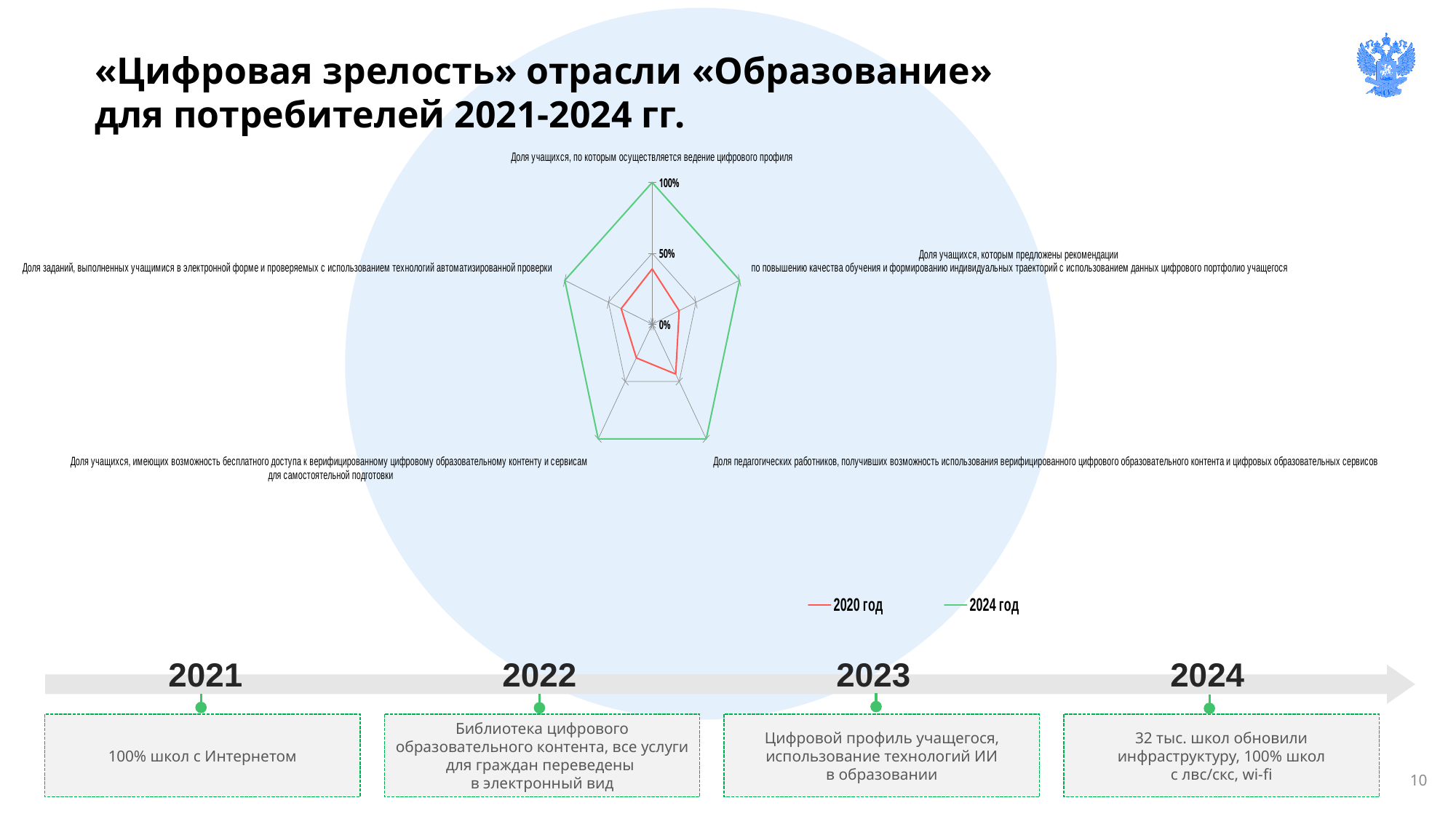
Is the 2024 год value for 'Доля учащихся, имеющих возможность бесплатного доступа к верифицированному цифровому образовательному контенту и сервисам для самостоятельной подготовки' greater or less than 50%? greater Which series has the larger value for 'Доля учащихся, которым предложены рекомендации по повышению качества обучения и формированию индивидуальных траекторий с использованием данных цифрового портфолио учащегося', 2020 год or 2024 год? 2024 год What is the 2024 год value for 'Доля учащихся, по которым осуществляется ведение цифрового профиля'? 100% What colour is the line for the 2024 год series? Green What is the highest percentage tick shown on the chart's axis? 100% Which years are listed in the chart legend? 2020 год and 2024 год What kind of chart is shown on the slide? Radar chart How many axes (categories) does the radar chart have? 5 Is the 2020 год value for 'Доля учащихся, по которым осуществляется ведение цифрового профиля' greater or less than 50%? less Is the 2020 год value for 'Доля заданий, выполненных учащимися в электронной форме и проверяемых с использованием технологий автоматизированной проверки' greater or less than 50%? less How many series does the chart legend list? 2 What is the 2024 год value for 'Доля педагогических работников, получивших возможность использования верифицированного цифрового образовательного контента и цифровых образовательных сервисов'? 100%